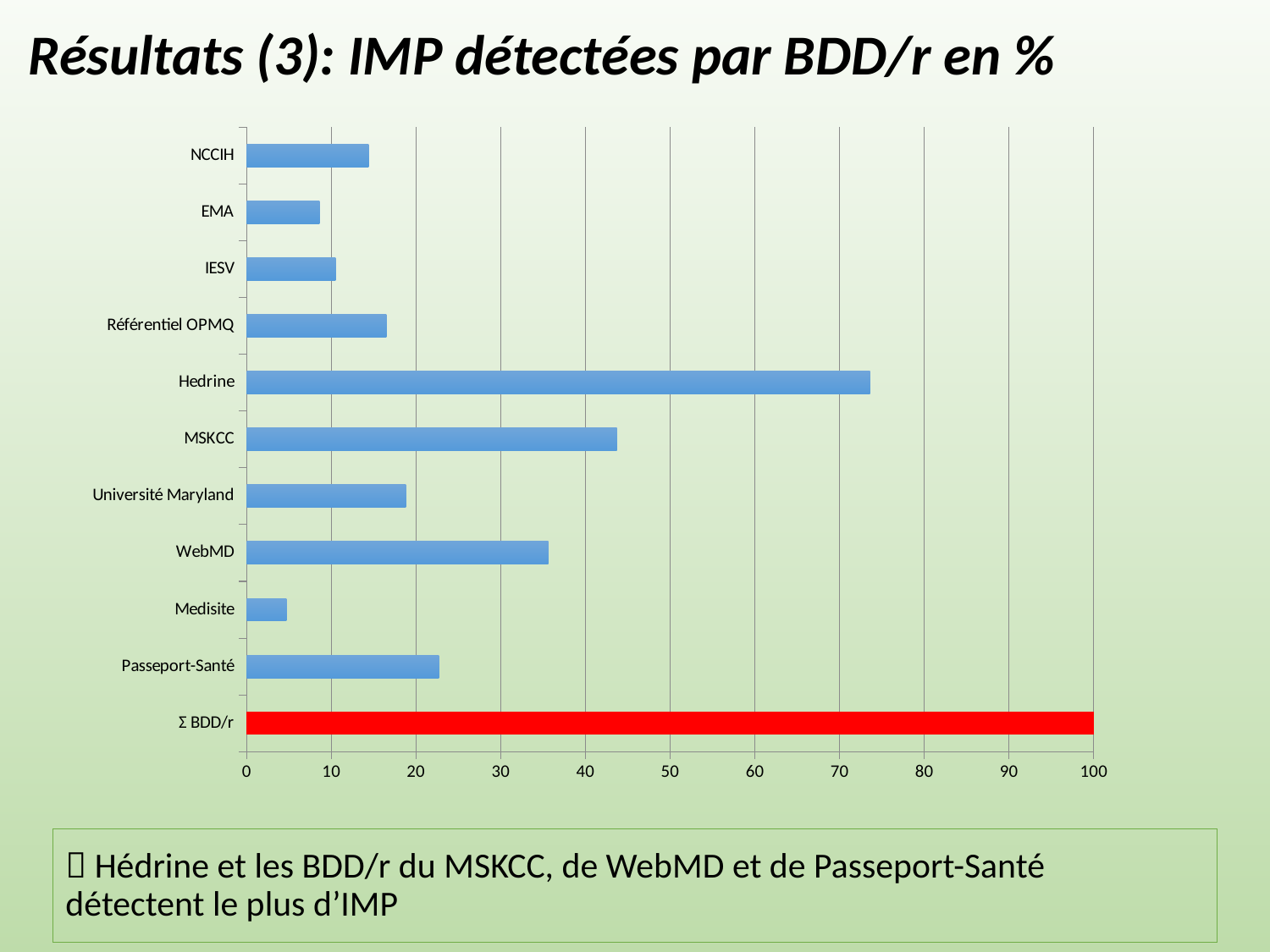
What kind of chart is shown on the slide? bar chart Is the value for Hedrine greater or less than 70? greater Is the value for Medisite greater or less than 10? less Is the value for WebMD greater or less than 40? less Which category has the lowest value in the chart? Medisite Which is larger, the value for Passeport-Santé or the value for Université Maryland? Passeport-Santé Which is larger, the value for Hedrine or the value for MSKCC? Hedrine What colour is the bar for Σ BDD/r? red What is the value for Σ BDD/r? 100 How many categories are plotted in the chart? 11 Which category has the highest value in the chart? Σ BDD/r